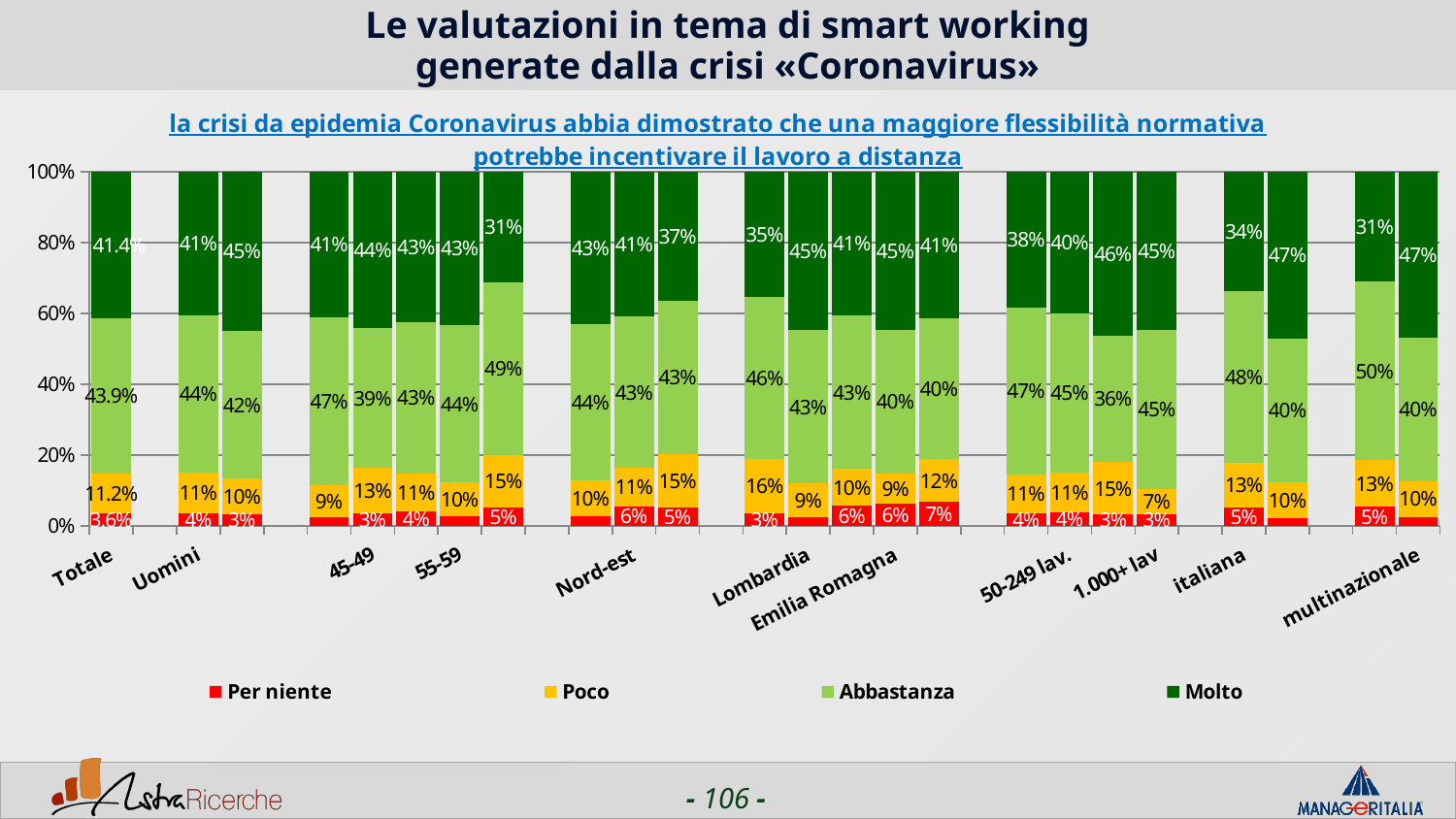
What is the 'Poco' value for 1.000+ lav? 7% What is the 'Per niente' value for the Totale bar? 3.6% What is the 'Abbastanza' value for the 'italiana' bar? 48% What kind of chart is shown on the slide? Stacked bar chart How many series does the legend list? 4 What is the 'Molto' value for Lombardia? 45% What is the 'Per niente' value for Nord-est? 6% What is the 'Abbastanza' value for Uomini? 44% For the Totale bar, what is the difference between the 'Abbastanza' and 'Molto' values? 2.5 percentage points What is the 'Molto' value for the Totale bar? 41.4% Which colour represents 'Per niente' in the legend? Red What is the 'Molto' value for the 45-49 age group? 44%